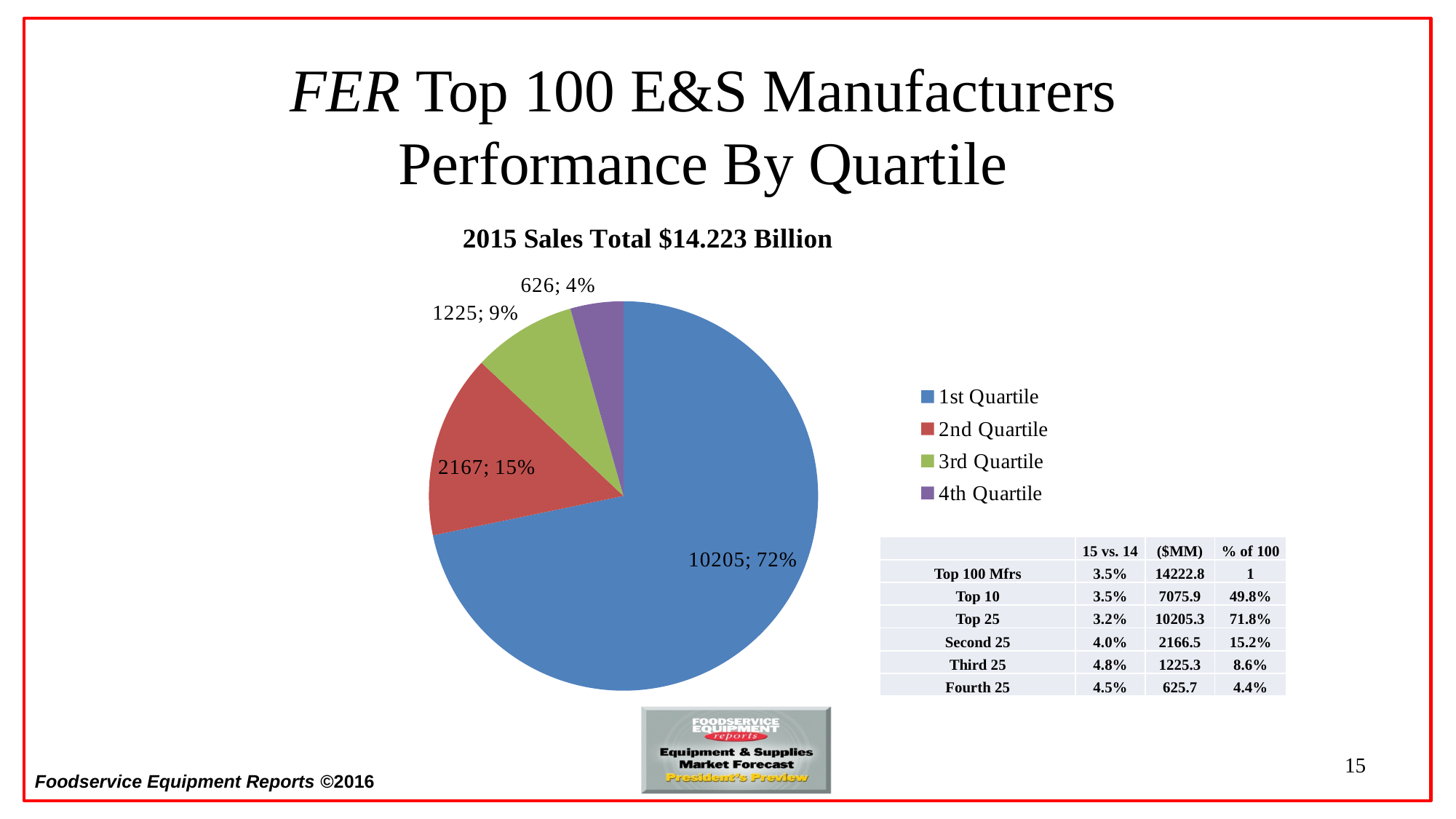
What value is labelled on the 3rd Quartile slice? 1225 What percentage share does the 4th Quartile slice show? 4% What is the difference between the 2nd Quartile value and the 3rd Quartile value? 942 Which is larger, the 3rd Quartile slice or the 4th Quartile slice? 3rd Quartile How many entries does the legend list? 4 How many slices does the pie chart have? 4 What percentage share does the 2nd Quartile slice show? 15% Which quartile has the smallest slice? 4th Quartile What is the chart's title? 2015 Sales Total $14.223 Billion What value is labelled on the 1st Quartile slice? 10205 What type of chart is shown on the slide? pie chart Which quartile has the largest slice? 1st Quartile